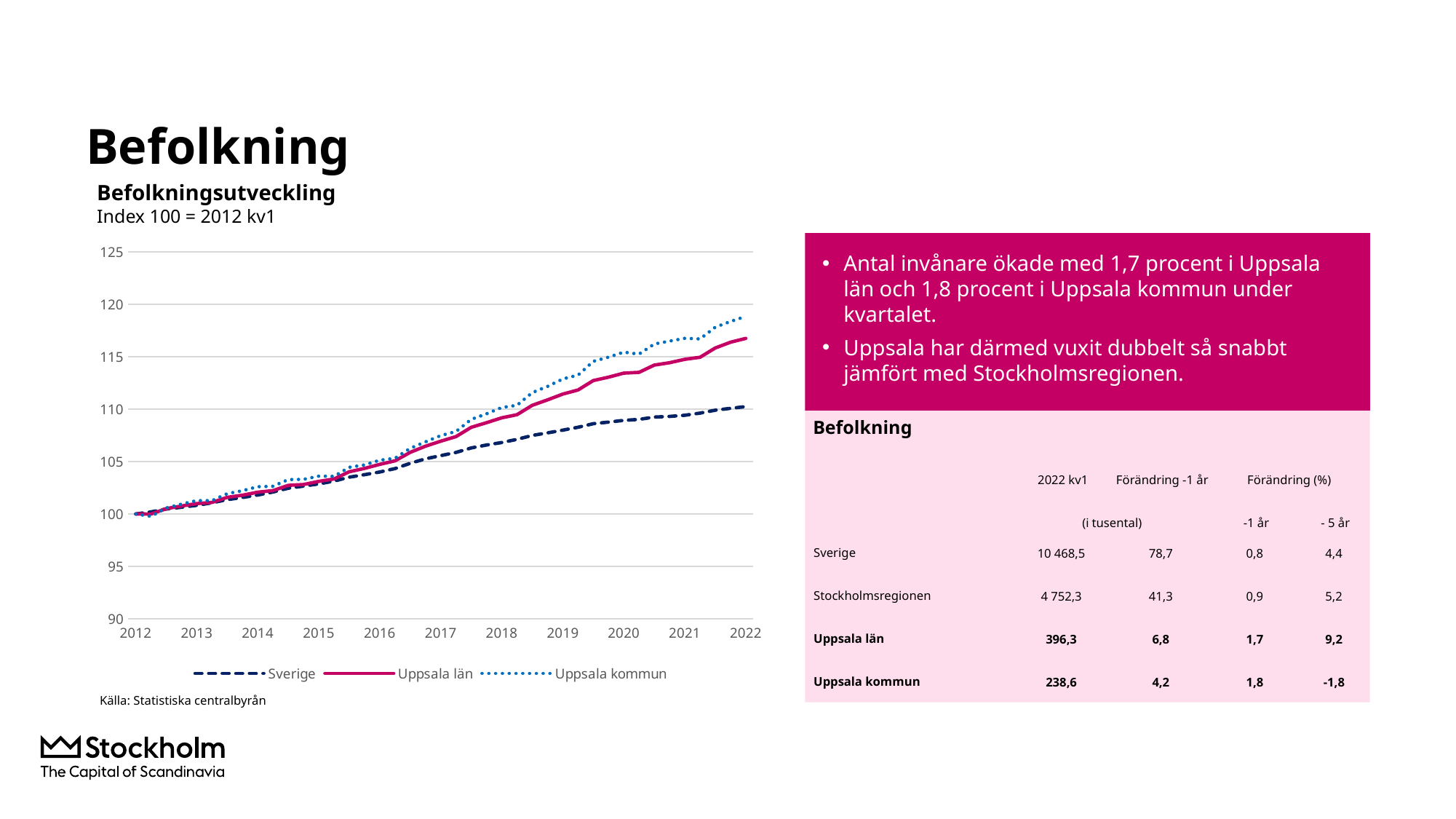
What is the title of the chart? Befolkningsutveckling Which series has the lowest value at the end of the chart in 2022? Sverige Is the value for Uppsala kommun in 2022 greater or less than 115? greater In 2022, which is larger: the value for Uppsala kommun or the value for Sverige? Uppsala kommun Is the value for Sverige in 2022 greater or less than 105? greater Which series has the highest value at the end of the chart in 2022? Uppsala kommun What is the index value of all series at the starting point, 2012 kv1? 100 How many series does the chart legend list? 3 Do the values for Uppsala län rise or fall from 2012 to 2022? rise What kind of chart is shown on the slide? line chart Is the value for Uppsala län in 2022 greater or less than 120? less